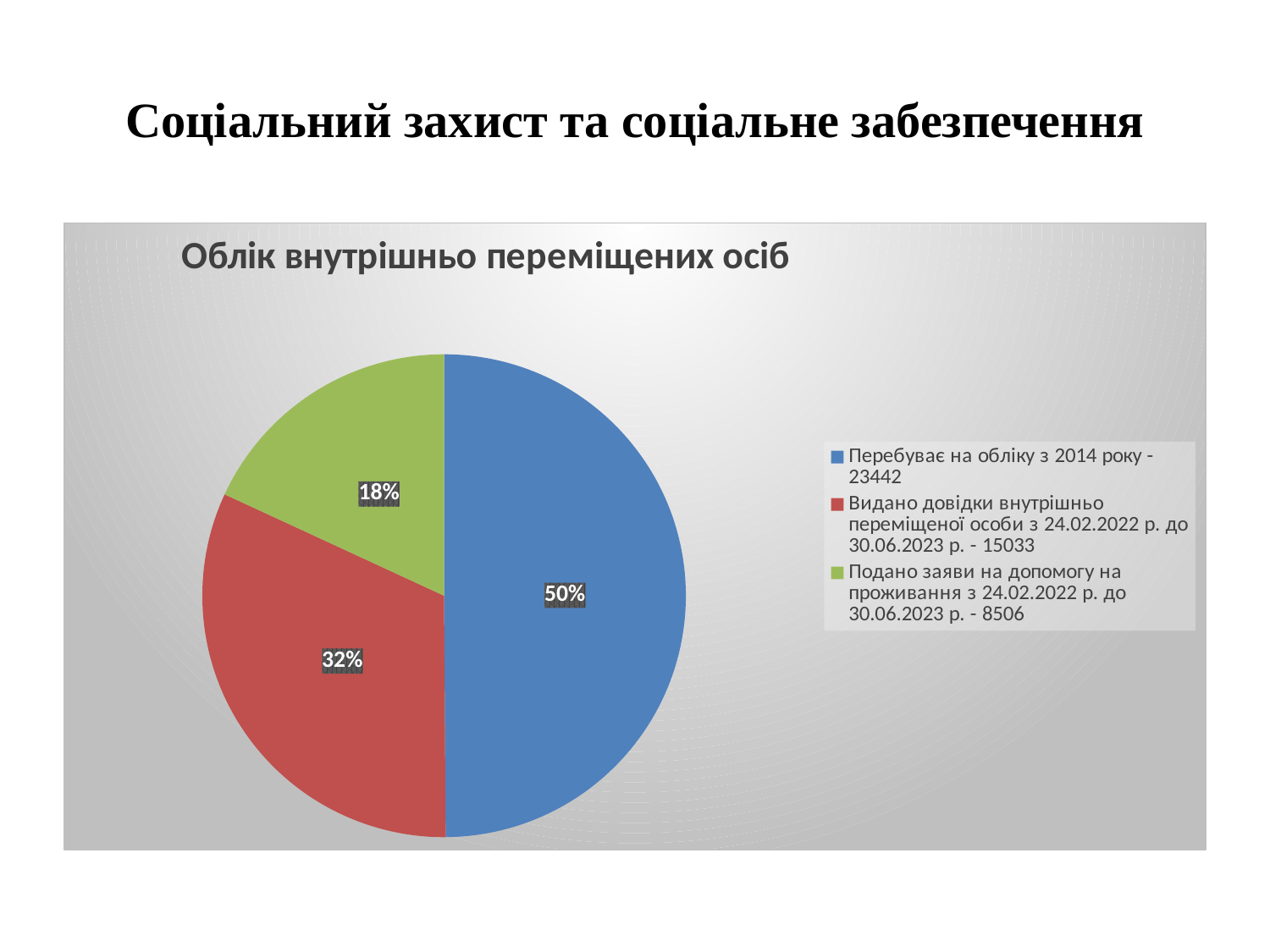
Which is larger: the share for "Видано довідки внутрішньо переміщеної особи" or the share for "Подано заяви на допомогу на проживання"? Видано довідки внутрішньо переміщеної особи What is the difference in percentage points between the 50% slice and the 32% slice? 18 How many entries does the legend list? 3 What kind of chart is shown on the slide? pie chart What colour is the slice for "Подано заяви на допомогу на проживання з 24.02.2022 р. до 30.06.2023 р. - 8506"? green How many slices does the pie chart have? 3 Which slice of the pie is the smallest? Подано заяви на допомогу на проживання з 24.02.2022 р. до 30.06.2023 р. - 8506 Which slice of the pie is the largest? Перебуває на обліку з 2014 року - 23442 What share of the pie is labelled for "Подано заяви на допомогу на проживання з 24.02.2022 р. до 30.06.2023 р. - 8506"? 18% What is the title of the chart? Облік внутрішньо переміщених осіб What share of the pie is labelled for "Видано довідки внутрішньо переміщеної особи з 24.02.2022 р. до 30.06.2023 р. - 15033"? 32% What share of the pie is labelled for "Перебуває на обліку з 2014 року - 23442"? 50%